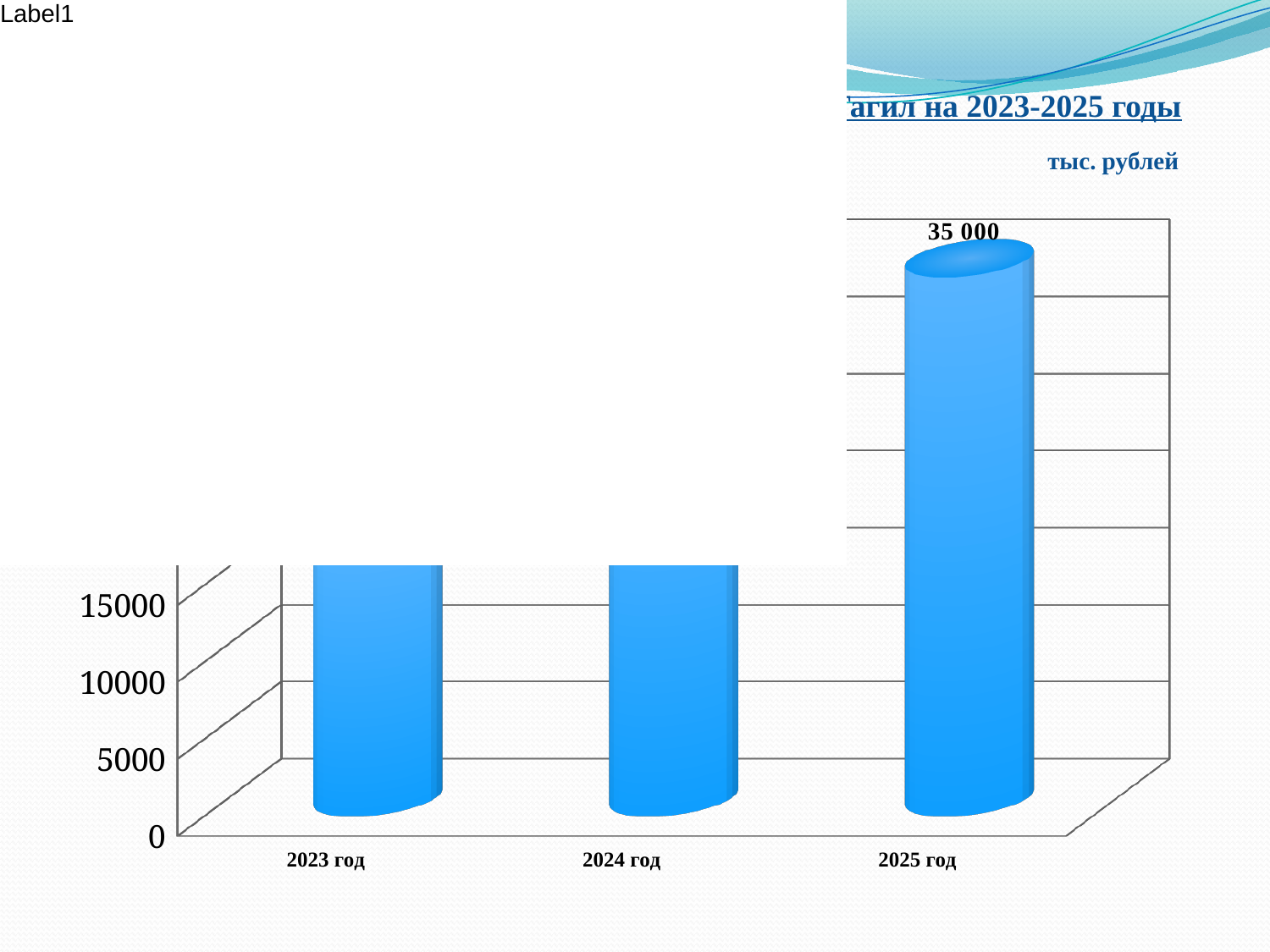
What is the label of the first category on the x axis? 2023 год What kind of chart is shown on the slide? bar chart Is the value for 2025 год greater or less than 15000? greater What is the value shown for 2025 год? 35 000 Is the value for 2024 год greater or less than 15000? greater How many categories (years) are shown on the x axis of the chart? 3 What unit of measurement is indicated above the chart? тыс. рублей Is the value for 2024 год greater or less than 5000? greater